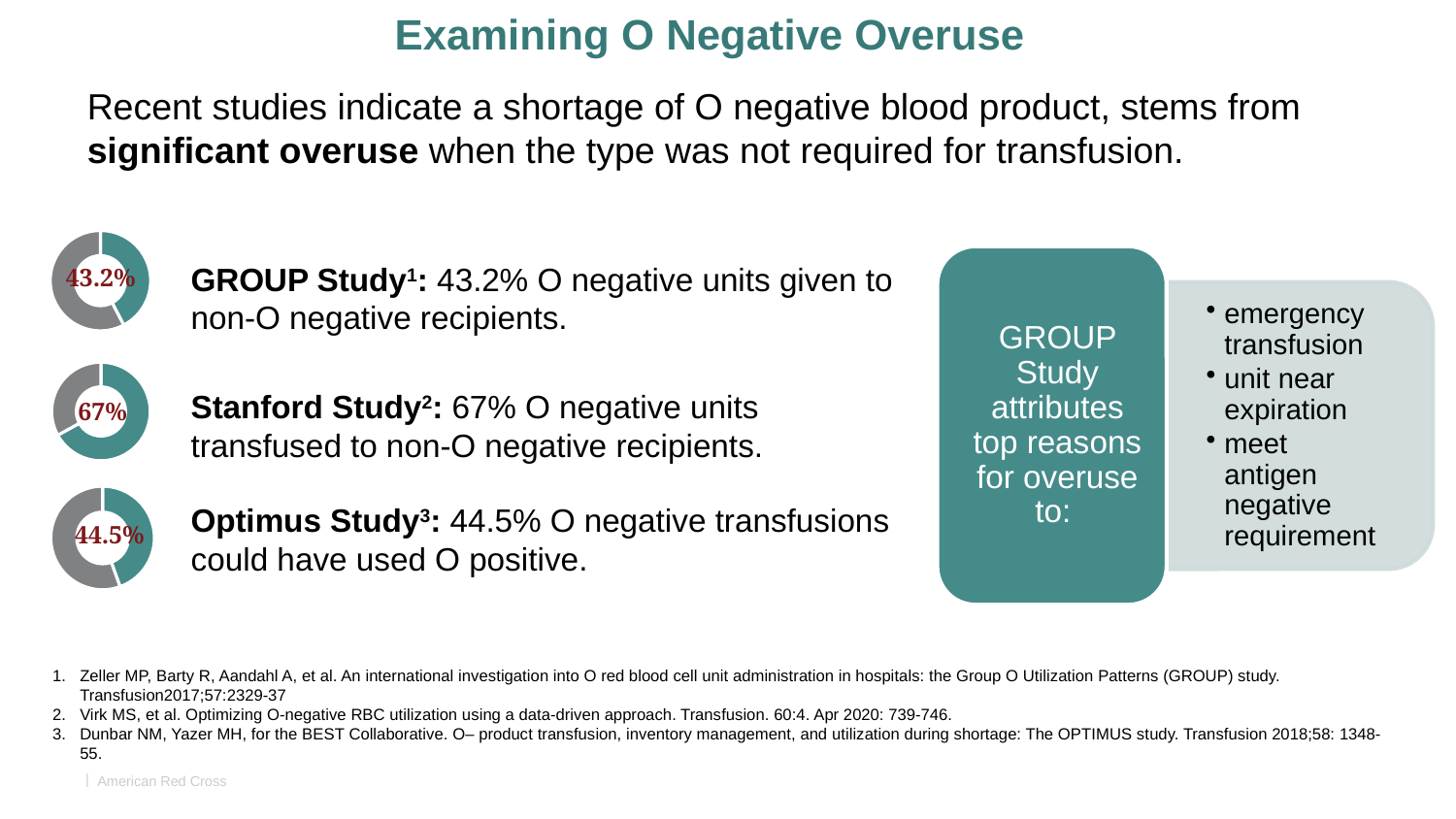
Of the three donut charts on the slide, which study's chart shows the lowest percentage? GROUP Study (43.2%) How many donut charts are shown on the slide? 3 What value is printed on the bottom donut chart next to the Optimus Study? 44.5% What share of the middle donut chart (Stanford Study) does the highlighted teal slice represent? 67% Which is larger: the percentage on the Stanford Study donut chart or the percentage on the Optimus Study donut chart? Stanford Study (67%) How many slices does each donut chart on the slide have? 2 What is the difference between the percentage shown on the Optimus Study donut chart and the GROUP Study donut chart? 1.3% What value is printed on the top donut chart next to the GROUP Study? 43.2% What is the difference between the percentage shown on the Stanford Study donut chart and the GROUP Study donut chart? 23.8% Of the three donut charts on the slide, which study's chart shows the highest percentage? Stanford Study (67%) What value is printed on the middle donut chart next to the Stanford Study? 67% What kind of chart is used to show the percentage for each study on the left side of the slide? Donut (pie) chart